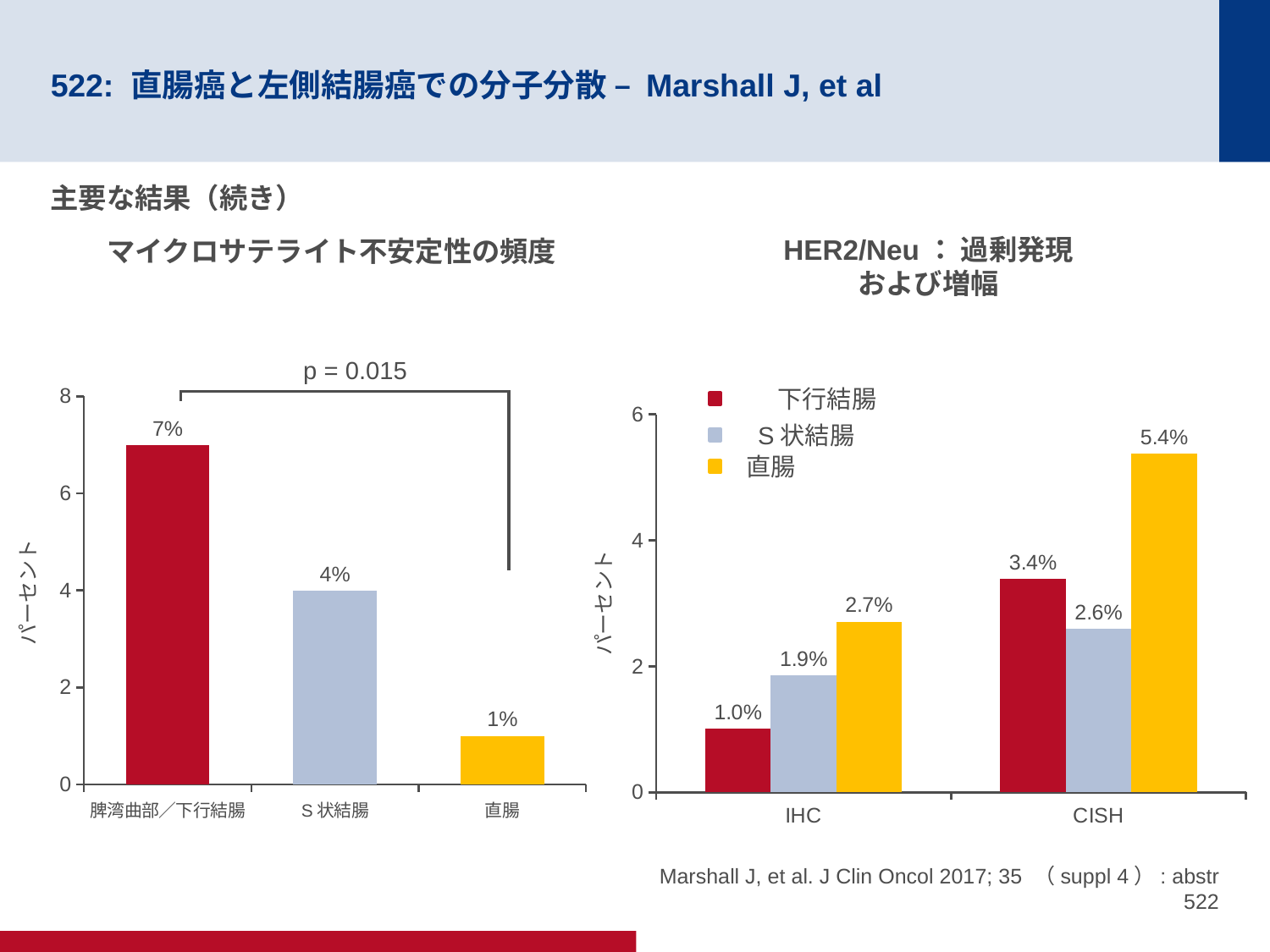
In the left chart (マイクロサテライト不安定性の頻度), which category has the lowest value? 直腸 In the right chart (HER2/Neu：過剰発現および増幅), which is larger: 下行結腸 in CISH or 直腸 in IHC? 下行結腸 in CISH In the right chart (HER2/Neu：過剰発現および増幅), which series has the highest value in CISH? 直腸 What type of chart is the right chart (HER2/Neu：過剰発現および増幅)? Bar chart In the right chart (HER2/Neu：過剰発現および増幅), what is the value for 直腸 in CISH? 5.4% In the left chart (マイクロサテライト不安定性の頻度), what is the difference between 脾湾曲部／下行結腸 and S 状結腸? 3% In the left chart (マイクロサテライト不安定性の頻度), how many categories are shown on the x axis? 3 In the right chart (HER2/Neu：過剰発現および増幅), what is the difference between 直腸 and S 状結腸 in IHC? 0.8% In the right chart (HER2/Neu：過剰発現および増幅), how many series does the legend list? 3 In the left chart (マイクロサテライト不安定性の頻度), what is the value for 脾湾曲部／下行結腸? 7% In the right chart (HER2/Neu：過剰発現および増幅), what is the value for 下行結腸 in IHC? 1.0% In the left chart (マイクロサテライト不安定性の頻度), what p-value is shown above the bars? p = 0.015